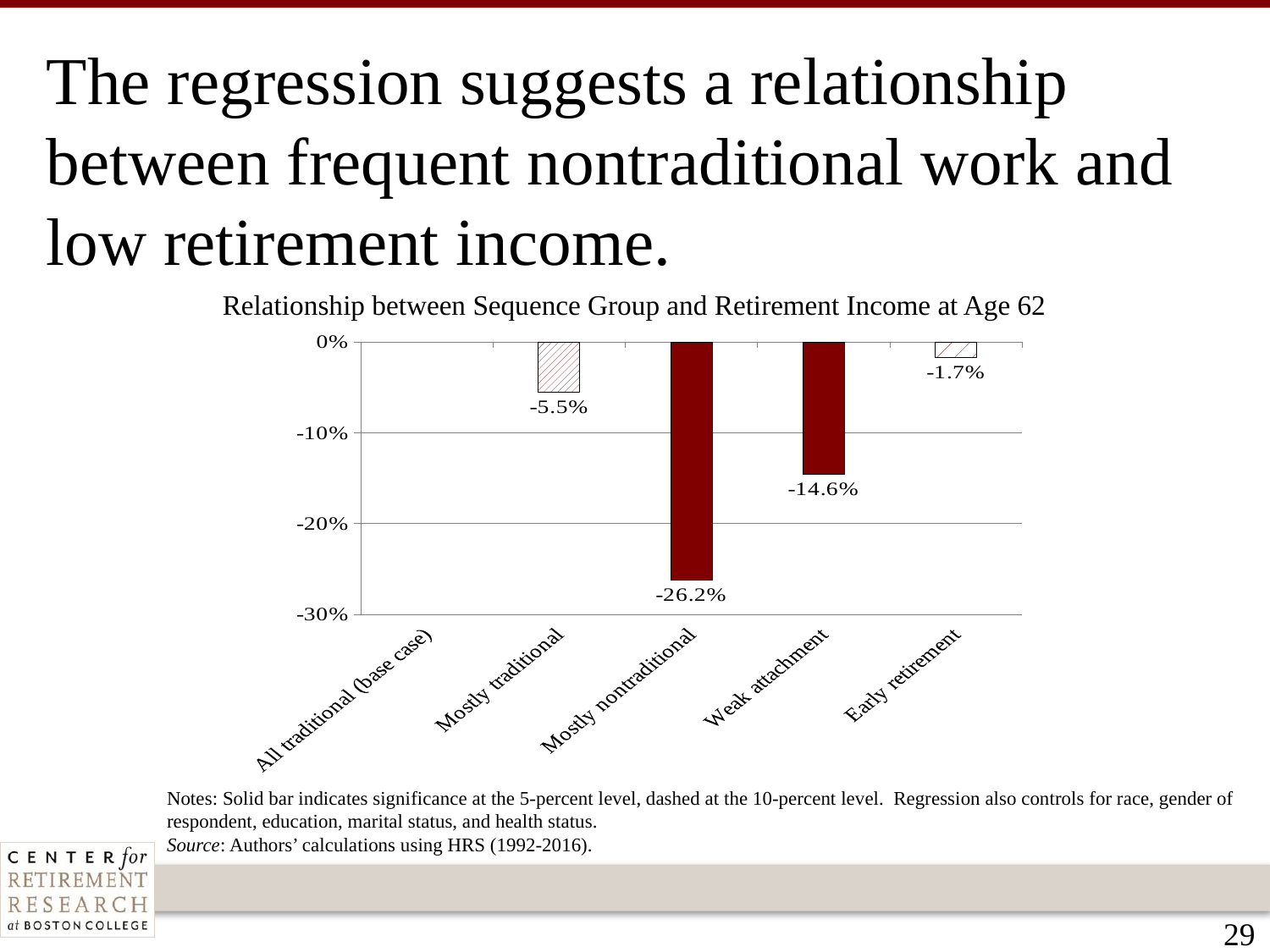
What is the value for Mostly traditional? -5.5% Which category has the lowest (most negative) value? Mostly nontraditional What is the value for Early retirement? -1.7% What is the difference between the values for Mostly nontraditional and Weak attachment? 11.6 percentage points Is the value for Mostly nontraditional greater or less than -20%? less Which is more negative, Mostly traditional or Weak attachment? Weak attachment Among the categories with a labeled bar, which has the value closest to zero? Early retirement What kind of chart is shown on the slide? Bar chart What is the value for Mostly nontraditional? -26.2% What is the title of the chart? Relationship between Sequence Group and Retirement Income at Age 62 What is the value for Weak attachment? -14.6% How many categories are shown on the x axis? 5